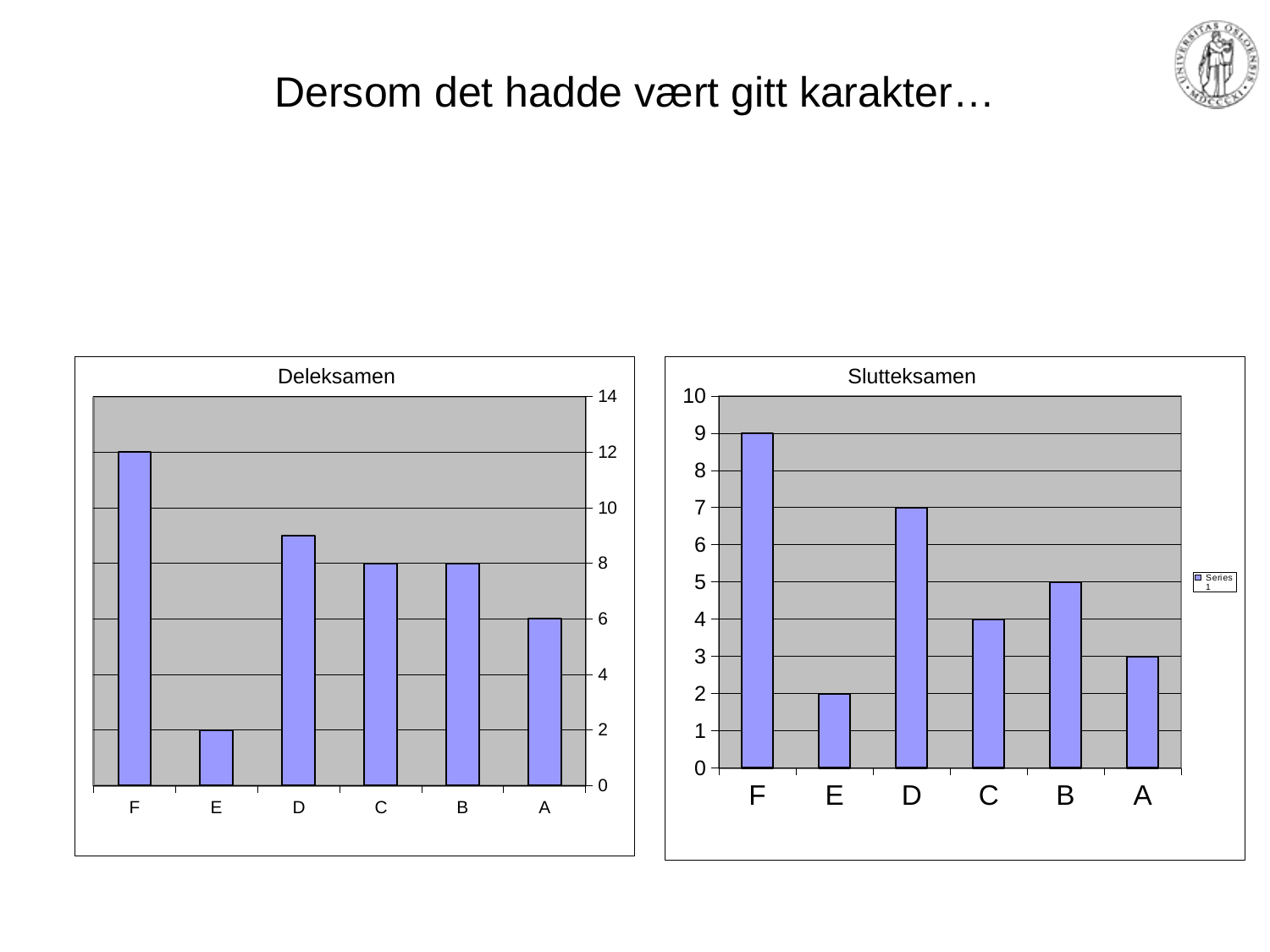
In the Deleksamen chart, what is the value for E? 2 In the Slutteksamen chart, what is the value for B? 5 In the Slutteksamen chart, what is the difference between the values for F and A? 6 In the Slutteksamen chart, what is the value for D? 7 In the Deleksamen chart, is the value for D greater or less than 8? greater In the Deleksamen chart, which category has the highest value? F What kind of chart is the Deleksamen chart? bar chart How many categories are shown on the x axis of the Slutteksamen chart? 6 In the Deleksamen chart, what is the value for F? 12 In the Deleksamen chart, what is the difference between the values for F and A? 6 In the Slutteksamen chart, which category has the lowest value? E In the Slutteksamen chart, which is larger, the value for C or the value for B? B